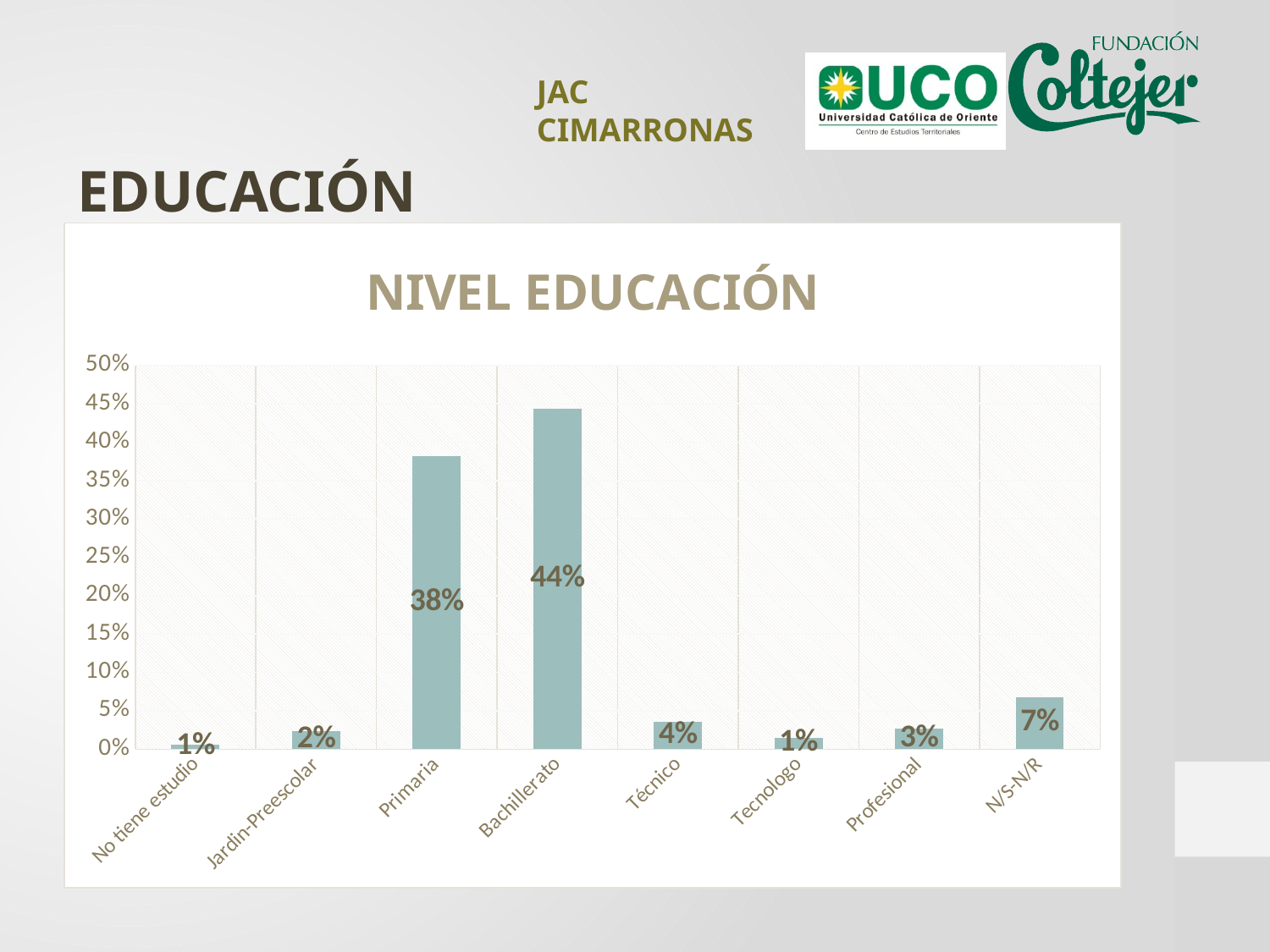
Which is larger, the value for Profesional or the value for N/S-N/R? N/S-N/R What is the value for N/S-N/R? 7% What kind of chart is shown? bar chart How many categories are shown on the x axis? 8 What is the difference between the values for Bachillerato and Primaria? 6% Which category has the highest value? Bachillerato What is the title of the chart? NIVEL EDUCACIÓN What is the value for Técnico? 4% What is the value for Primaria? 38% Is the value for Primaria greater or less than 30%? greater What is the value for Jardin-Preescolar? 2% What is the value for Bachillerato? 44%